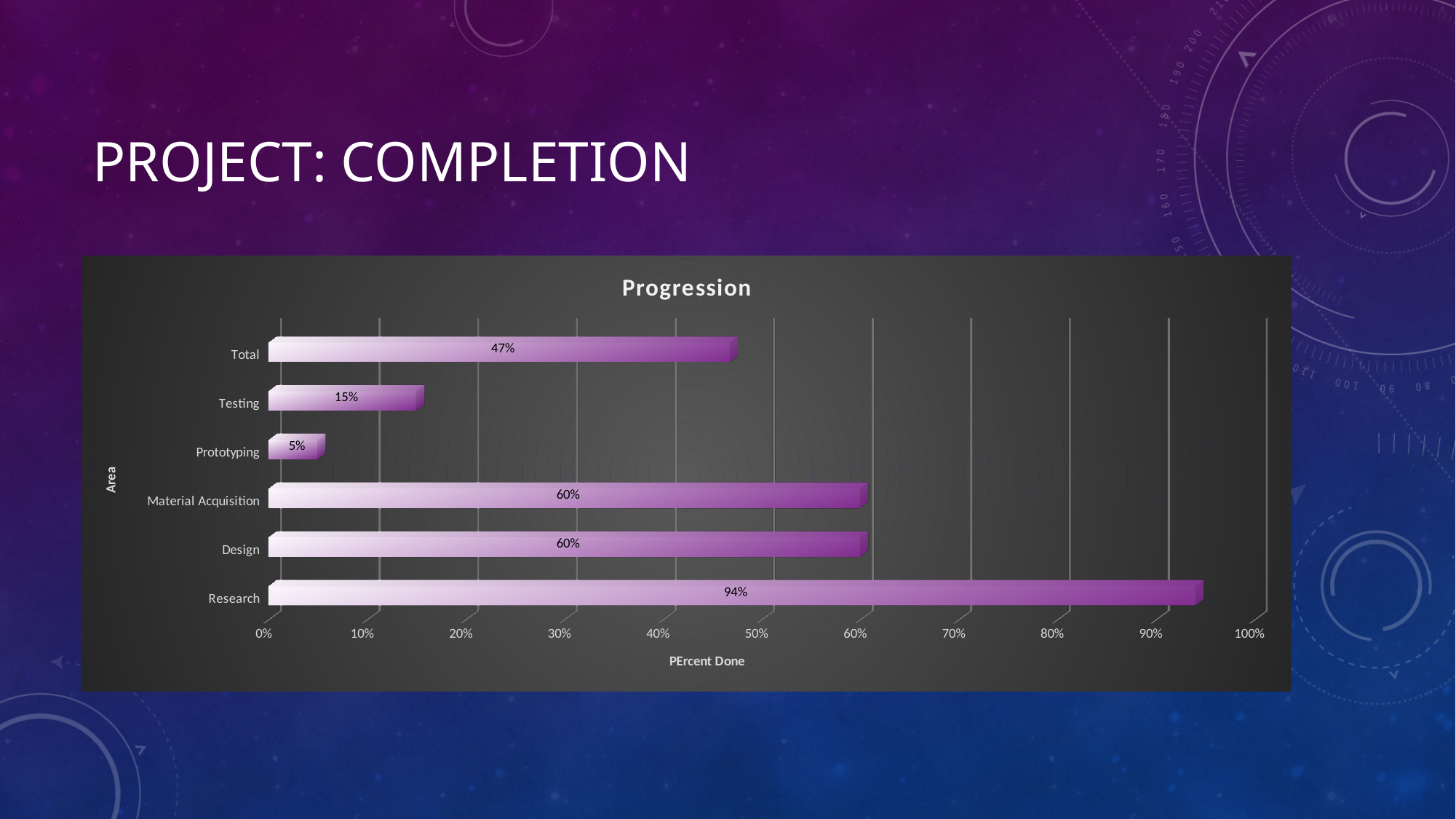
Which area has the lowest percent done? Prototyping What is the difference between the values for Testing and Prototyping? 10% What is the value for Total? 47% What kind of chart is shown on the slide? bar chart What is the value for Testing? 15% Is the value for Material Acquisition greater or less than 50%? greater What is the difference between the values for Research and Design? 34% Which area has the highest percent done? Research What is the value for Research? 94% Which is larger, the value for Total or the value for Testing? Total What is the title of the chart? Progression How many areas are shown in the chart? 6